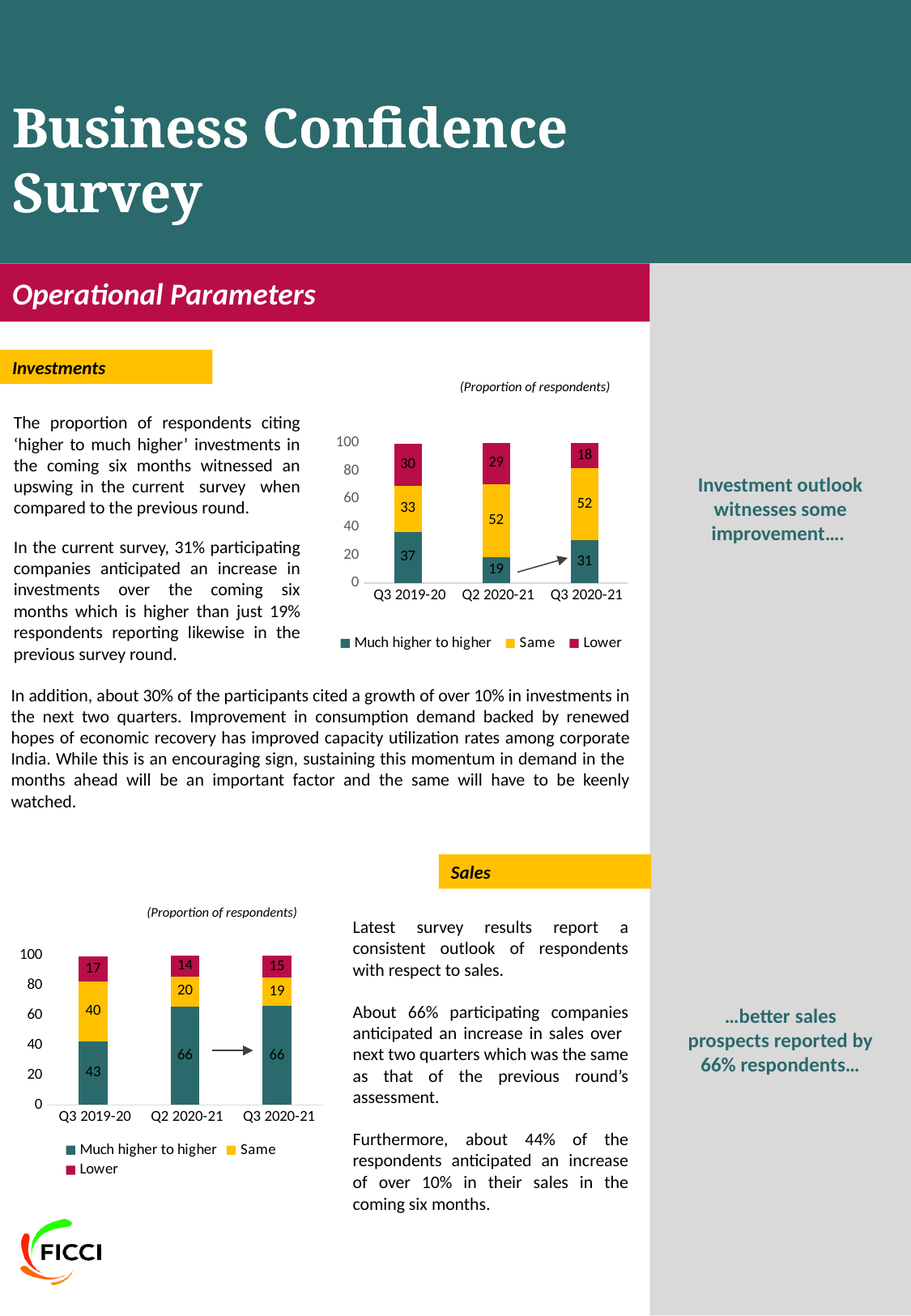
In the Investments chart, what is the total of the stacked bar for Q3 2019-20? 100 How many quarters are shown on the x axis of the Sales chart? 3 In the Sales chart, what is the value for 'Lower' in Q2 2020-21? 14 How many series does the legend of the Investments chart list? 3 What type of chart is the Sales chart? Stacked bar chart In the Investments chart, what is the value for 'Same' in Q2 2020-21? 52 In the Sales chart, what is the value for 'Much higher to higher' in Q3 2019-20? 43 In the Sales chart, is the 'Much higher to higher' value for Q2 2020-21 larger or smaller than that for Q3 2019-20? larger In the Sales chart, which quarter has the highest value for 'Same'? Q3 2019-20 In the Investments chart, what is the difference between the 'Lower' values for Q3 2019-20 and Q3 2020-21? 12 In the Investments chart, what is the value for 'Much higher to higher' in Q3 2020-21? 31 In the Investments chart, which quarter has the lowest value for 'Much higher to higher'? Q2 2020-21